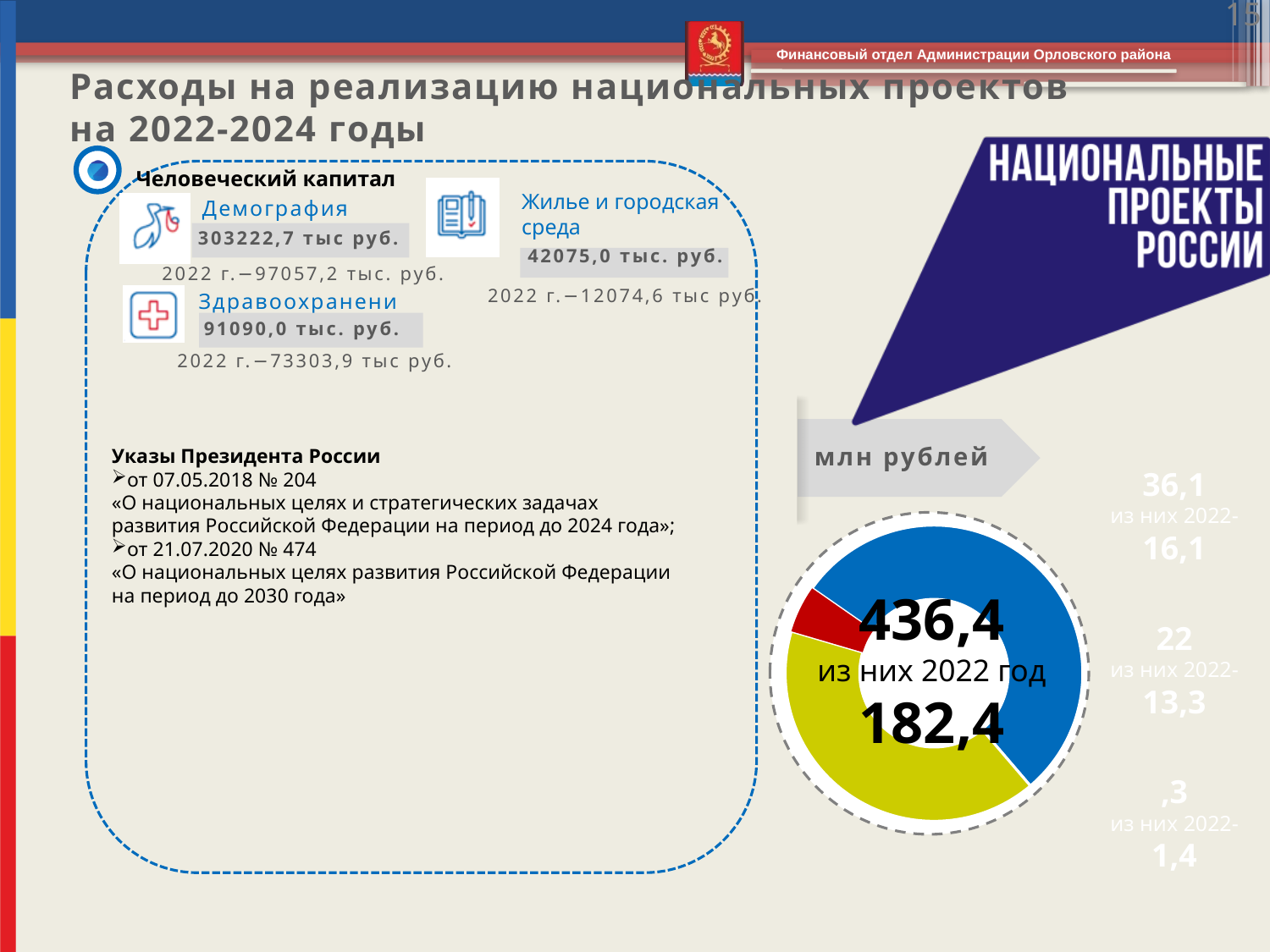
Is the blue slice or the red slice larger in the doughnut chart? blue How many slices does the doughnut chart on the right contain? 3 Does the doughnut chart have a legend? No What unit is indicated in the grey arrow above the doughnut chart? млн рублей Which colour slice is the largest in the doughnut chart? blue What total value is printed in the centre of the doughnut chart? 436,4 According to the centre of the doughnut chart, what is the value for 2022 (из них 2022 год)? 182,4 Which colour slice is the smallest in the doughnut chart? red What kind of chart is shown on the right side of the slide? doughnut chart